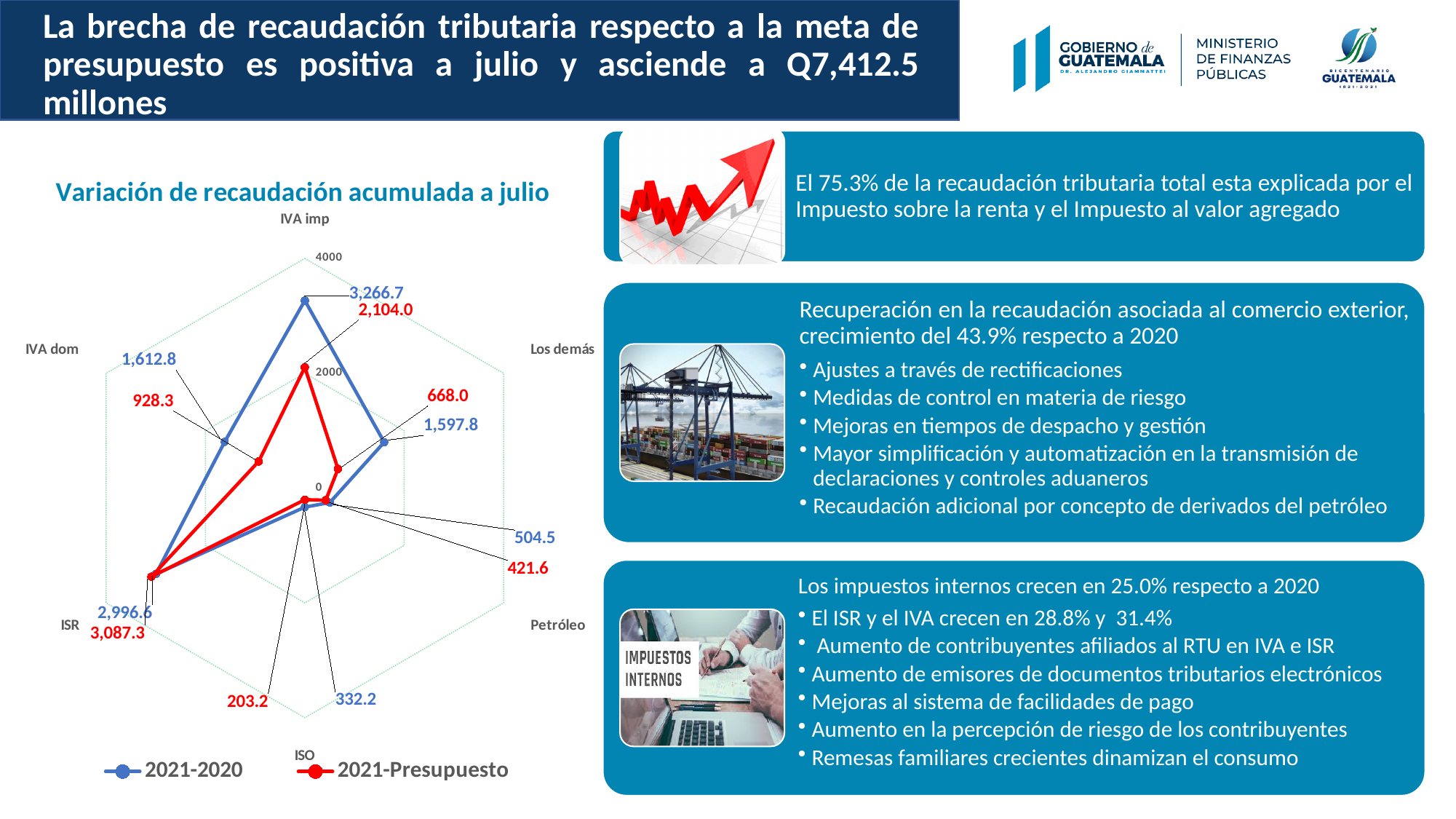
What is the difference between the 2021-2020 and 2021-Presupuesto values for IVA dom? 684.5 What is the 2021-2020 value for ISO? 332.2 What is the title of the chart on the slide? Variación de recaudación acumulada a julio What is the 2021-Presupuesto value for ISR? 3,087.3 For Petróleo, which series has the larger value, 2021-2020 or 2021-Presupuesto? 2021-2020 What kind of chart is shown on the slide? Radar chart How many series does the chart legend list? 2 How many categories (axes) does the radar chart have? 6 What is the 2021-Presupuesto value for Los demás? 668.0 Which category has the lowest 2021-Presupuesto value? ISO Which category has the highest 2021-2020 value? IVA imp What is the 2021-2020 value for IVA imp? 3,266.7